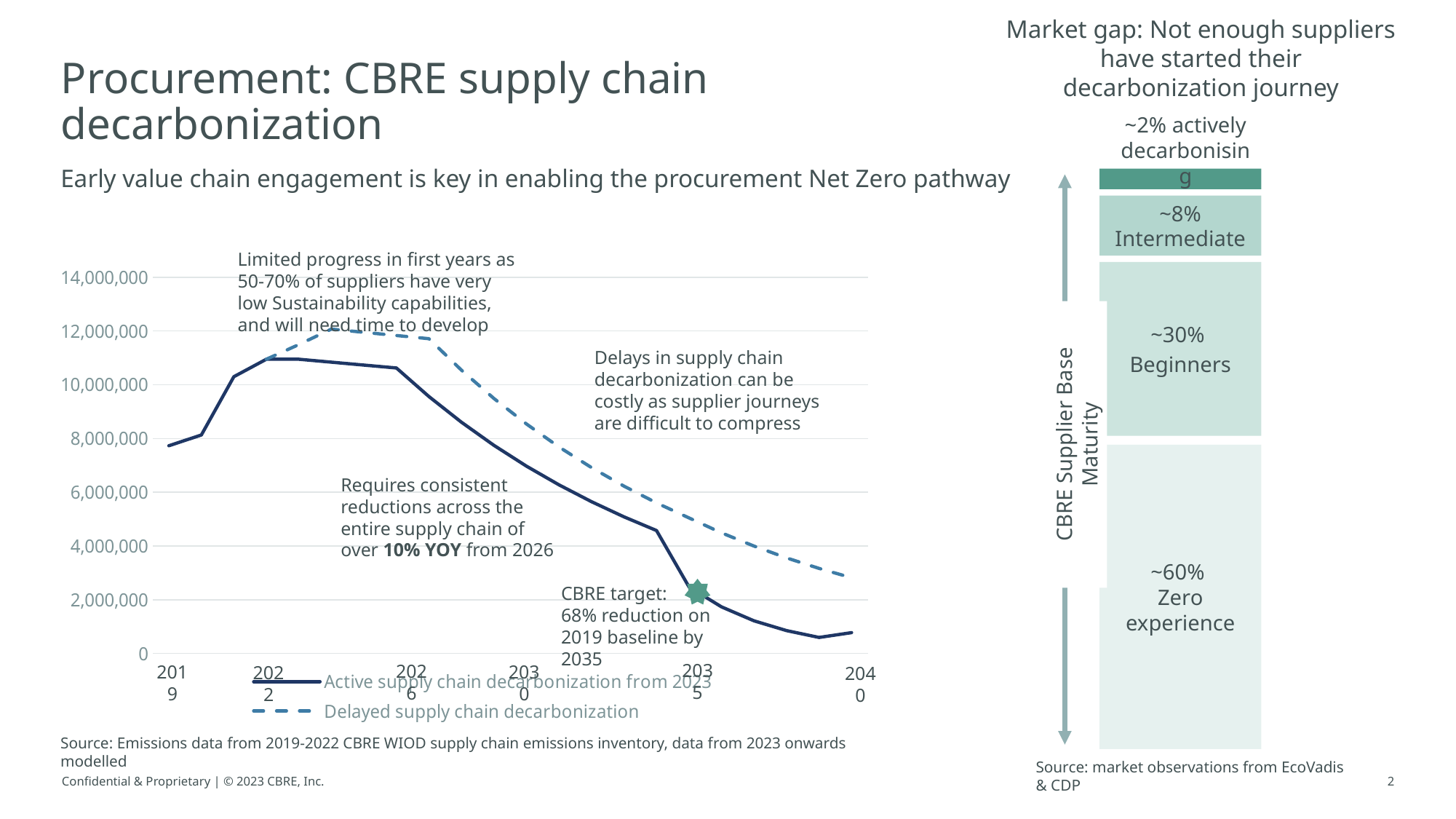
In the supplier maturity graphic on the right, what share of the CBRE supplier base is labelled as Beginners? ~30% In the emissions line chart, does the Active supply chain decarbonization series rise or fall between 2026 and 2040? Fall How many series does the legend of the emissions line chart list? 2 In the emissions line chart, is the value for Active supply chain decarbonization in 2030 greater or less than 8,000,000? less What kind of chart is the emissions chart on the left of the slide? Line chart How many year labels are shown on the x axis of the emissions line chart? 6 In the emissions line chart, which series has the higher value in 2035, Active supply chain decarbonization from 2023 or Delayed supply chain decarbonization? Delayed supply chain decarbonization In the emissions line chart, what is the highest value shown on the y axis? 14,000,000 In the emissions line chart, is the value for Active supply chain decarbonization in 2019 greater or less than 6,000,000? greater In the emissions line chart, which series is drawn with a dashed line? Delayed supply chain decarbonization In the emissions line chart, is the value for Active supply chain decarbonization in 2040 greater or less than 2,000,000? less